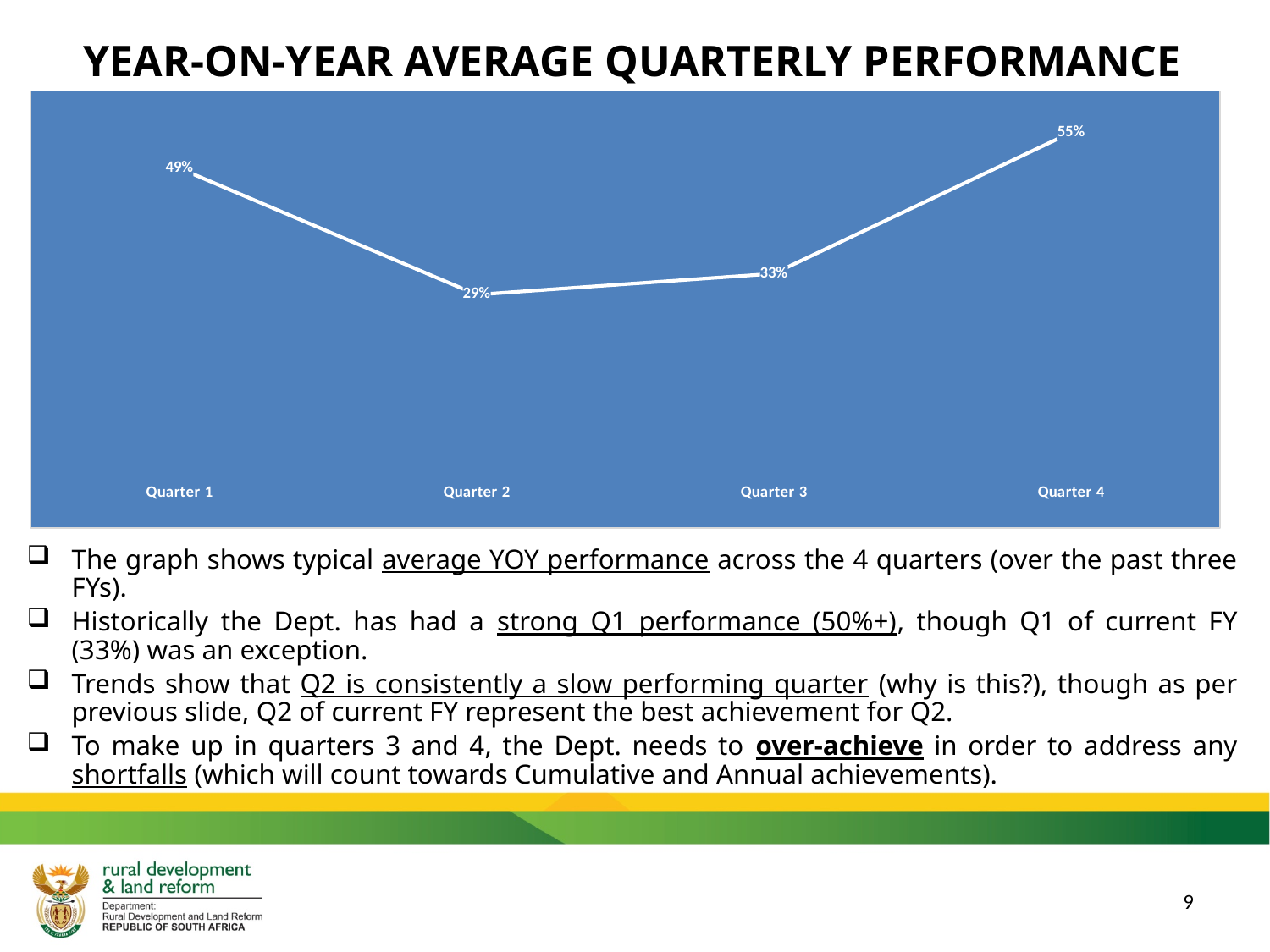
How many quarters are plotted on the chart? 4 What is the value for Quarter 1? 49% What is the value for Quarter 2? 29% Which quarter has the lowest value? Quarter 2 What is the value for Quarter 4? 55% Which is larger, the value for Quarter 2 or the value for Quarter 3? Quarter 3 What kind of chart is shown on the slide? Line chart Does the value rise or fall from Quarter 2 to Quarter 4? Rise What is the difference between the values for Quarter 1 and Quarter 2? 20% What is the value for Quarter 3? 33% What is the difference between the values for Quarter 4 and Quarter 1? 6% Which quarter has the highest value? Quarter 4